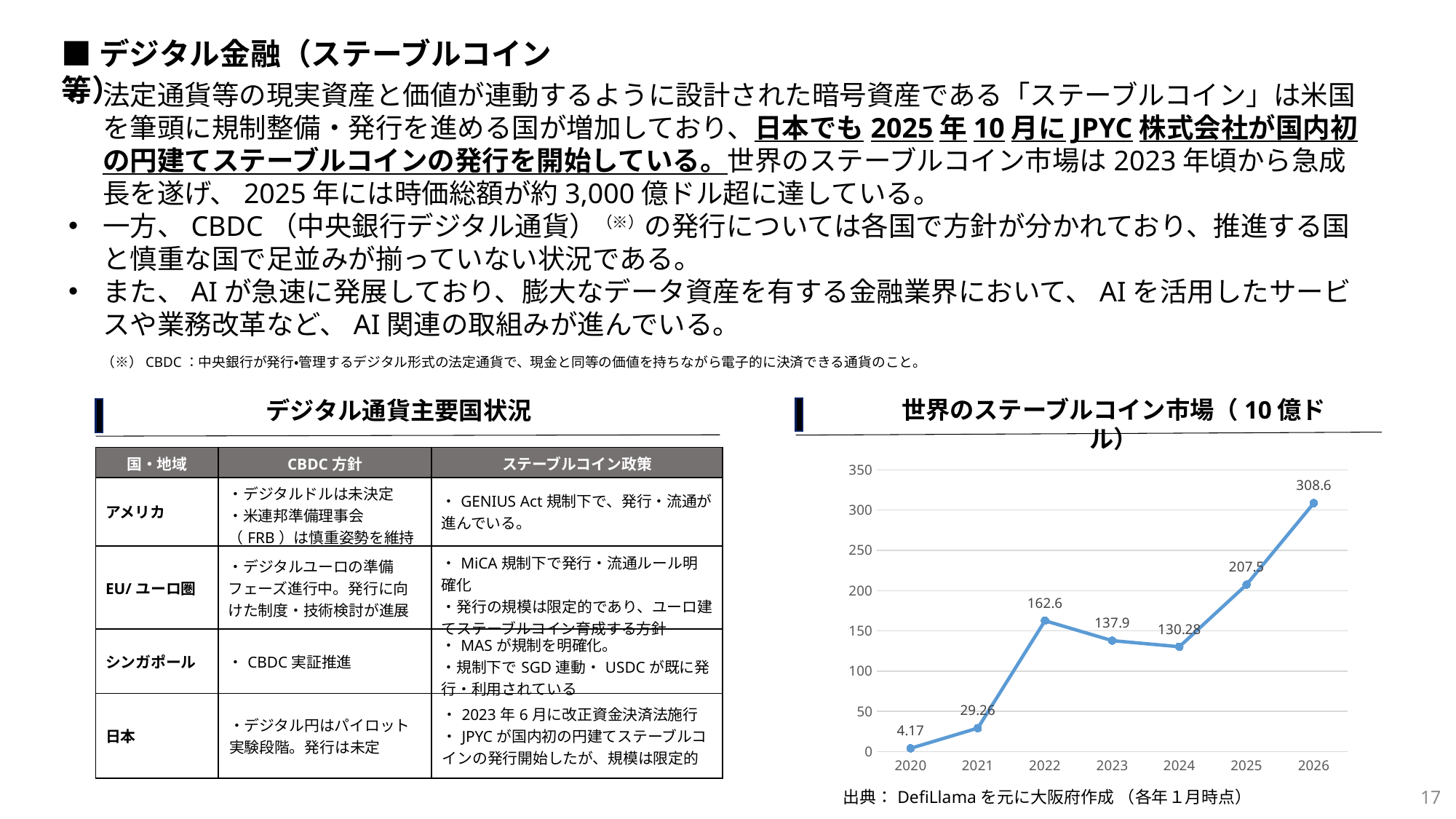
What kind of chart is the world stablecoin market chart? line chart Which is larger in the world stablecoin market chart, the value for 2022 or the value for 2023? 2022 What is the difference between the 2026 and 2025 values in the world stablecoin market chart? 101.1 What unit is stated in the title of the world stablecoin market chart? 10億ドル In the world stablecoin market chart, does the value rise or fall from 2022 to 2024? fall Which year has the highest value in the world stablecoin market chart? 2026 What is the value for 2020 in the world stablecoin market chart? 4.17 How many data points are plotted in the world stablecoin market chart? 7 Is the value for 2025 in the world stablecoin market chart greater or less than 200? greater Which year has the lowest value in the world stablecoin market chart? 2020 What is the value for 2024 in the world stablecoin market chart? 130.28 What is the value for 2022 in the world stablecoin market chart? 162.6